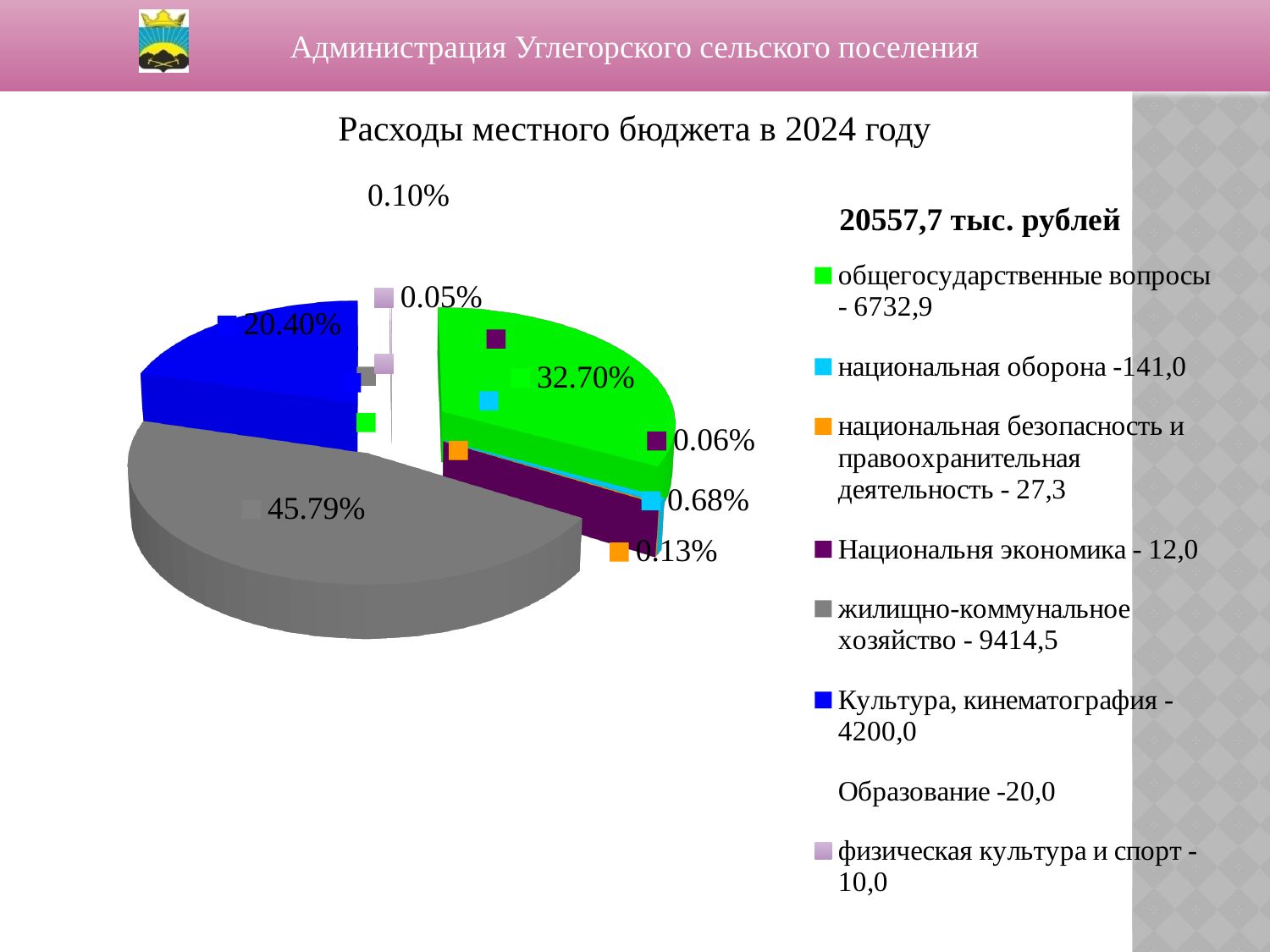
What percentage share is shown for жилищно-коммунальное хозяйство? 45.79% What kind of chart is shown on the slide? pie chart Which category has the largest share of the pie? жилищно-коммунальное хозяйство What is the title of the chart? 20557,7 тыс. рублей What amount is listed in the legend for Образование? 20,0 How many categories does the legend list? 8 What percentage share is shown for Культура, кинематография? 20.40% What amount is listed in the legend for национальная оборона? 141,0 Which category has the smallest share of the pie? физическая культура и спорт What is the difference in percentage points between the share for жилищно-коммунальное хозяйство and the share for общегосударственные вопросы? 13.09% Which is larger: the share for общегосударственные вопросы or the share for Культура, кинематография? общегосударственные вопросы What percentage share is shown for общегосударственные вопросы? 32.70%